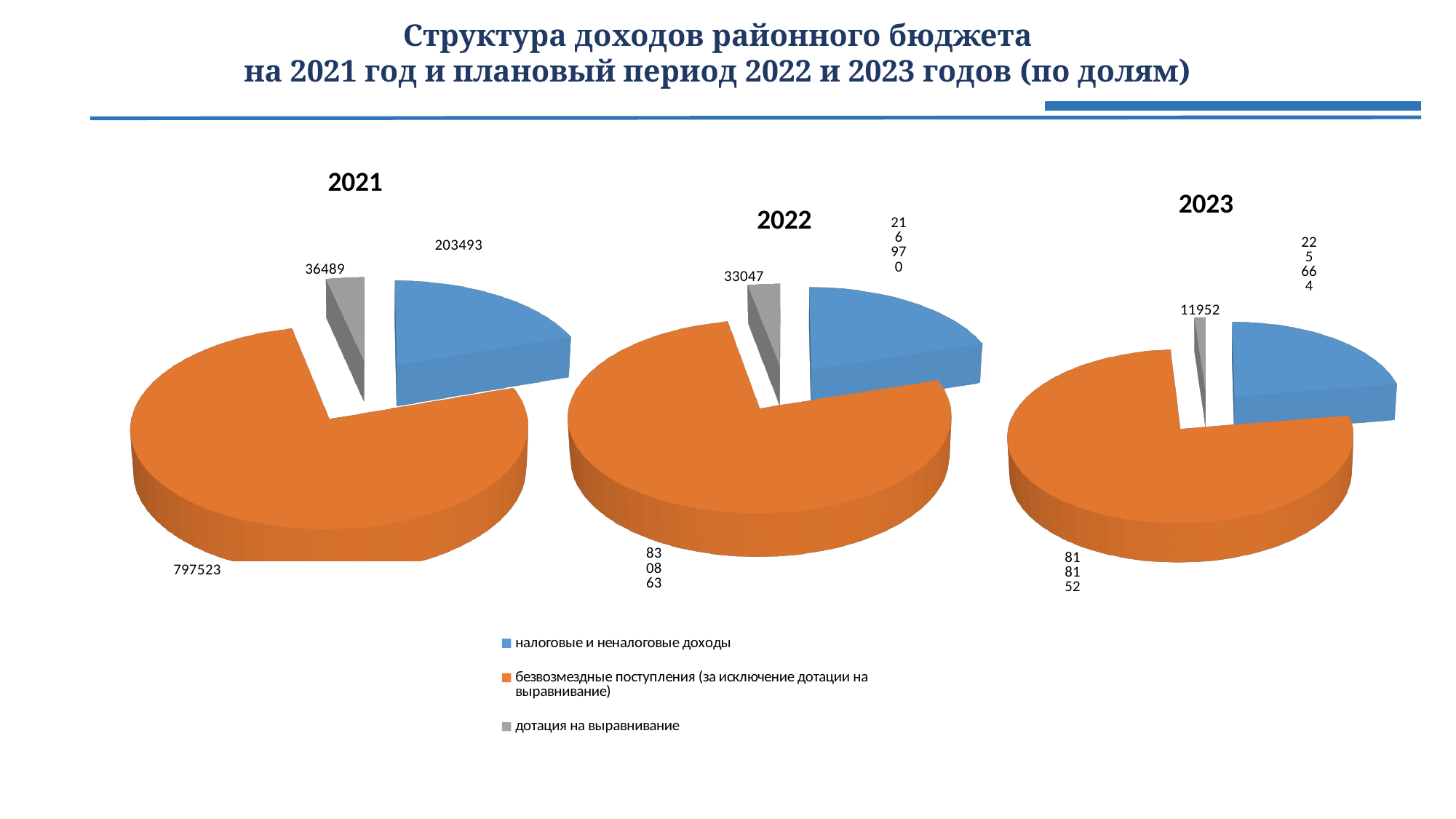
What kind of chart is used for the 2021, 2022 and 2023 data on this slide? pie chart In the 2021 pie chart, what is the value for безвозмездные поступления (за исключение дотации на выравнивание)? 797523 How many categories does the legend list? 3 In the 2023 pie chart, which category has the smallest slice? дотация на выравнивание How many pie charts are shown on the slide? 3 In the 2021 pie chart, what is the value for дотация на выравнивание? 36489 In the 2021 pie chart, what is the value for налоговые и неналоговые доходы? 203493 In the 2021 pie chart, which category has the largest slice? безвозмездные поступления (за исключение дотации на выравнивание) In the 2023 pie chart, what is the value for дотация на выравнивание? 11952 Which is larger: дотация на выравнивание in the 2021 chart or in the 2023 chart? 2021 In the 2021 pie chart, what is the difference between безвозмездные поступления (797523) and налоговые и неналоговые доходы (203493)? 594030 In the 2022 pie chart, what is the value for дотация на выравнивание? 33047